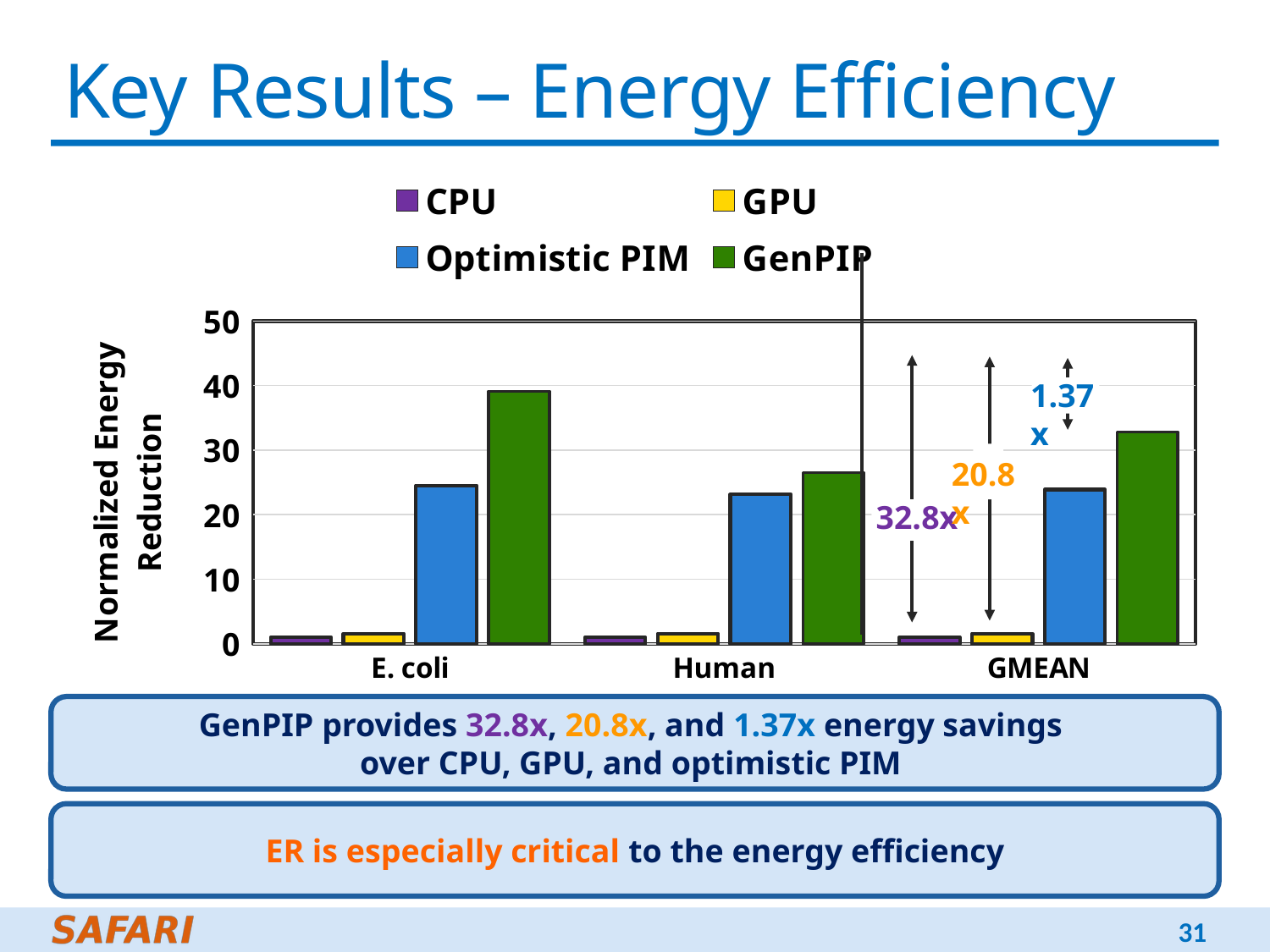
What kind of chart is shown on the slide? bar chart Is the GenPIP value for E. coli greater or less than 30? greater Which series has the highest bar for E. coli? GenPIP Is the Optimistic PIM value for Human greater or less than 30? less Is the GenPIP value for GMEAN greater or less than 30? greater Which is larger: the GenPIP bar for E. coli or the GenPIP bar for Human? E. coli Which series has the highest bar for GMEAN? GenPIP Which is larger for Human: the Optimistic PIM bar or the GenPIP bar? GenPIP What is the label of the y axis? Normalized Energy Reduction How many categories are shown on the x axis? 3 How many series does the legend list? 4 What colour are the GenPIP bars? green